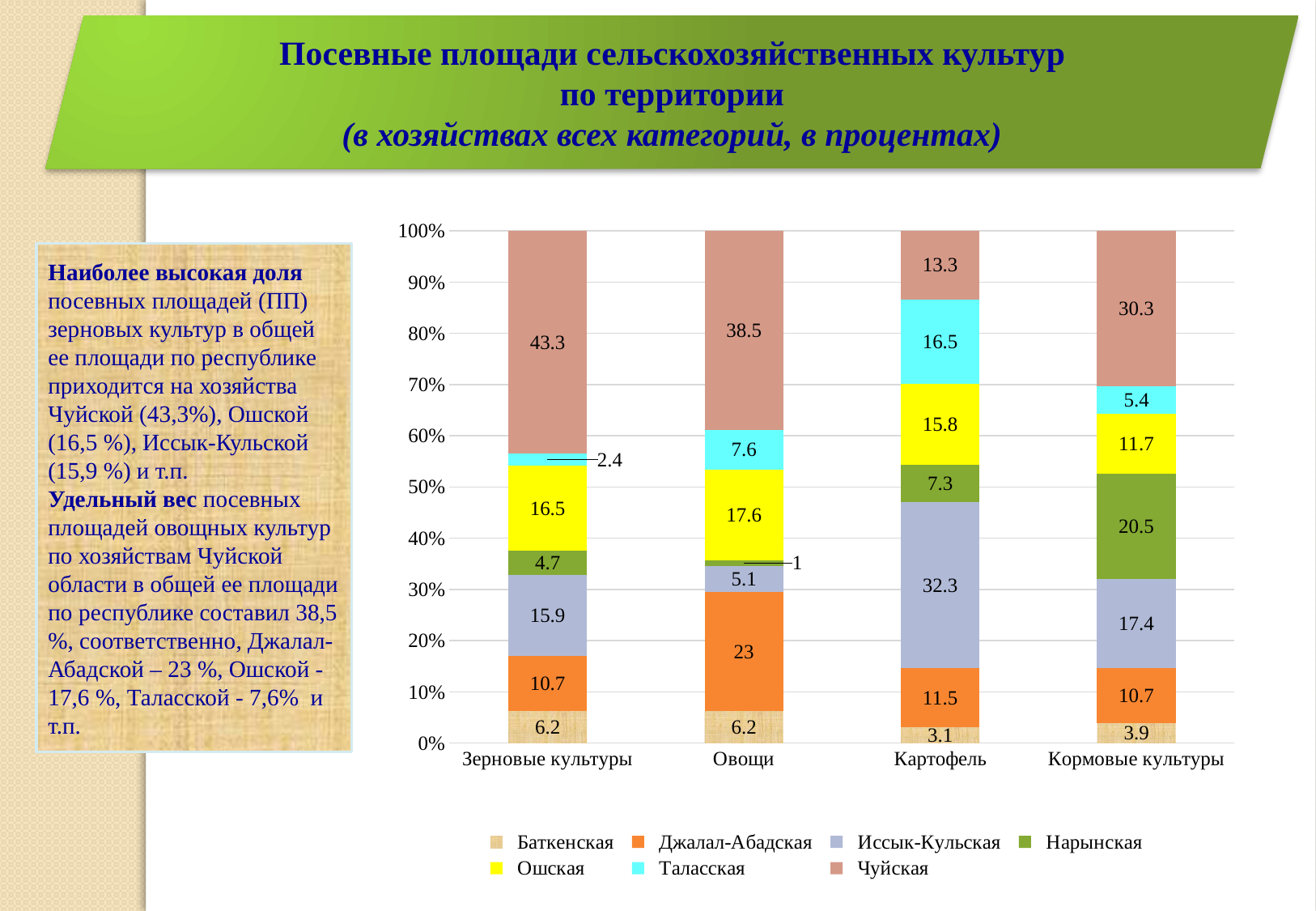
Which is larger: the Ошская value for Овощи or the Ошская value for Картофель? Овощи How many regions does the legend list? 7 What is the value for Джалал-Абадская in the Овощи bar? 23 Which region has the smallest share of the Овощи bar? Нарынская How many crop categories are shown on the x axis? 4 Which colour represents Таласская in the chart? Cyan (light blue) What is the value for Иссык-Кульская in the Картофель bar? 32.3 What type of chart is shown on the slide? Stacked bar chart Which region has the largest share of the Картофель bar? Иссык-Кульская What is the difference between the Чуйская values for Зерновые культуры and Овощи? 4.8 What is the value for Нарынская in the Кормовые культуры bar? 20.5 What share does Чуйская have for Зерновые культуры? 43.3